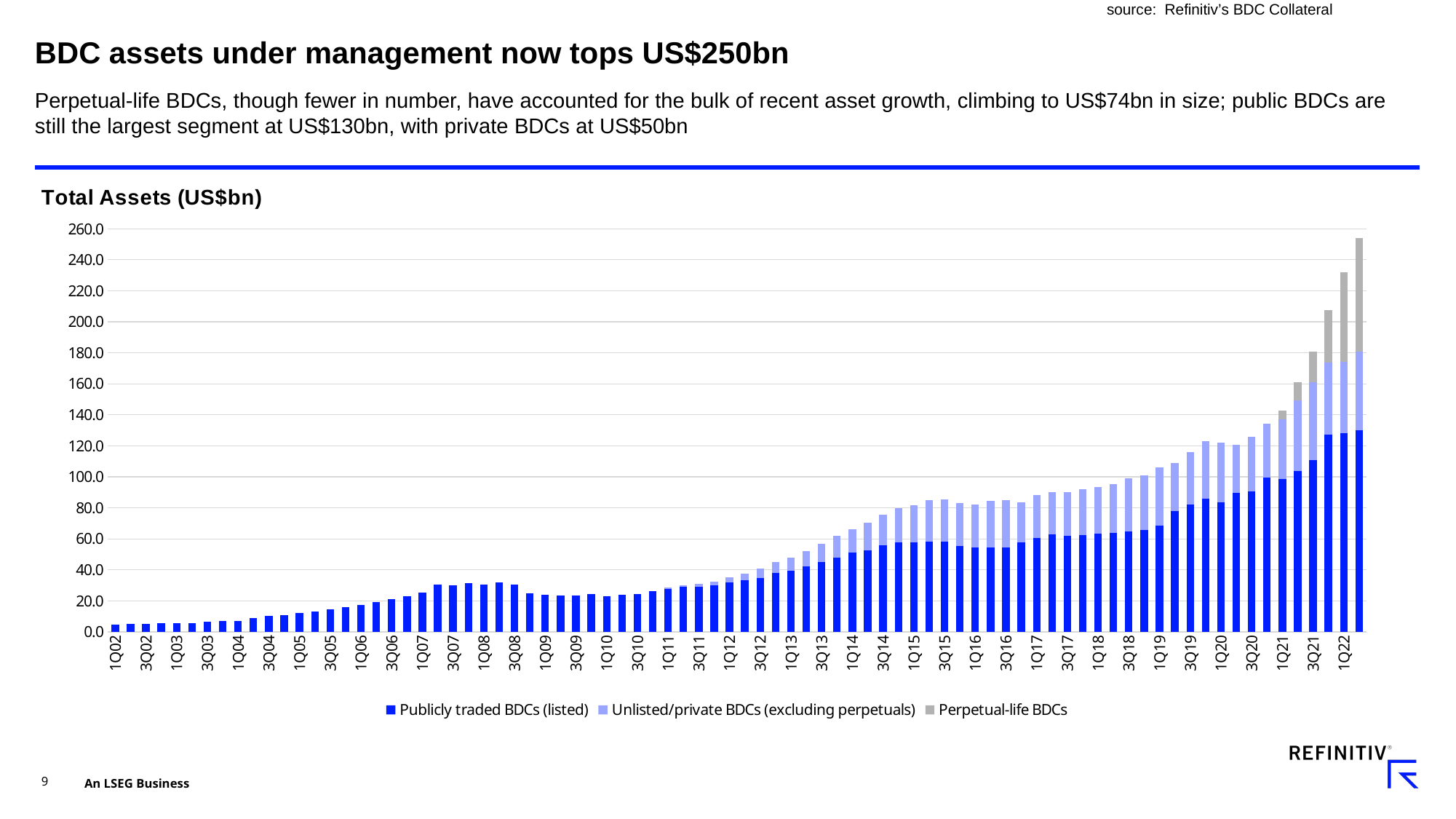
Which series is shown in grey in the chart? Perpetual-life BDCs Do total assets generally rise or fall from 1Q02 to 1Q22? Rise What kind of chart is shown on the slide? Stacked bar chart Is the total value for 1Q19 greater or less than 100? greater How many series does the legend list? 3 Is the Publicly traded BDCs (listed) value for 1Q22 greater or less than 120? greater Which quarter has the larger total, 1Q10 or 1Q15? 1Q15 Which quarter has the larger total, 3Q07 or 3Q09? 3Q07 Is the total value for 3Q07 greater or less than 40? less What is the title of the chart? Total Assets (US$bn)